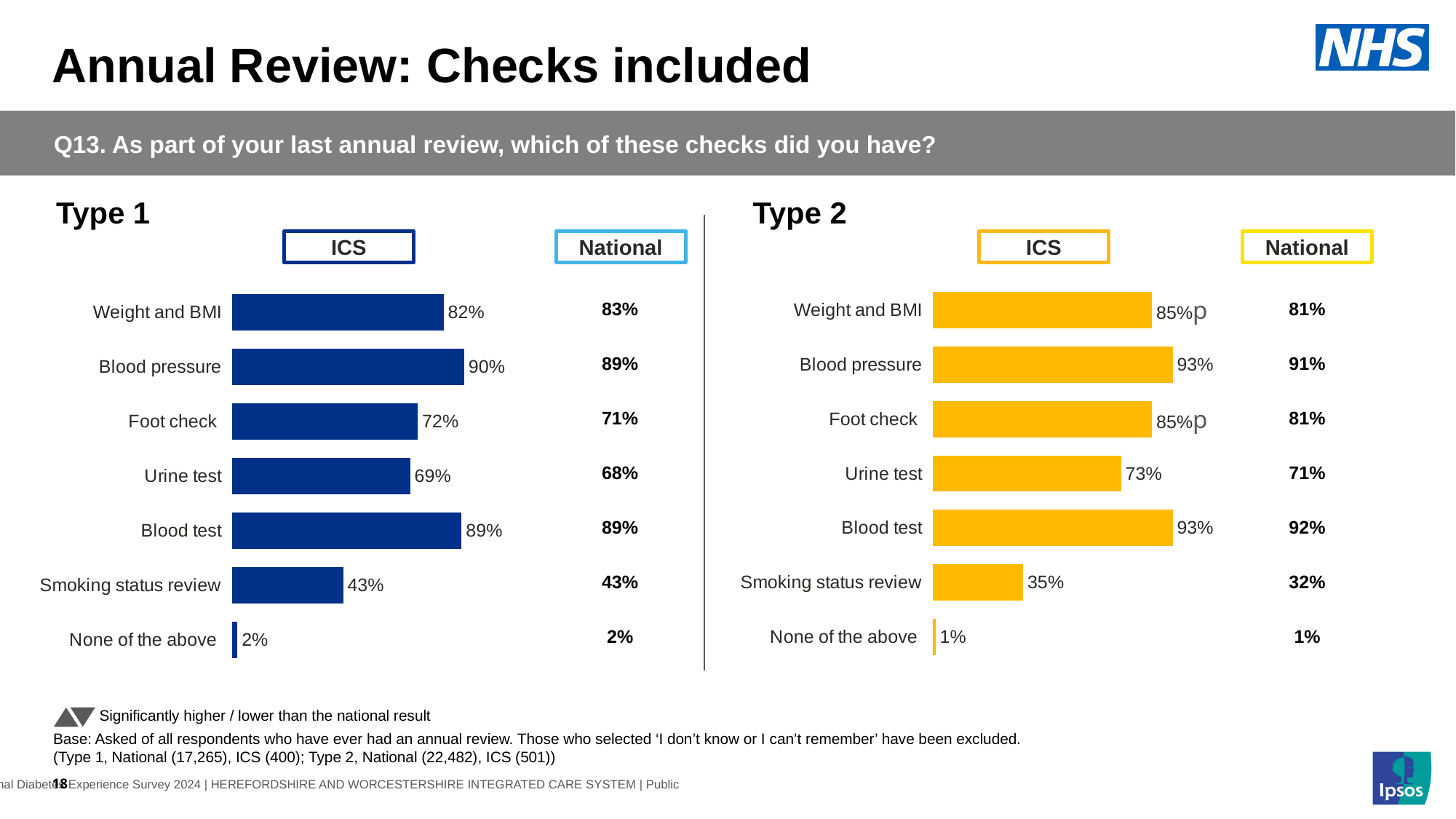
What type of chart is used for the Type 1 ICS results? Bar chart In the Type 1 chart, what is the ICS value for Blood pressure? 90% In the Type 2 chart, what is the difference between the ICS and National values for Weight and BMI? 4 percentage points In the Type 2 chart, what is the National value for Smoking status review? 32% In the Type 1 chart, which is larger: the ICS value for Foot check or the ICS value for Urine test? Foot check How many categories are shown in the Type 2 chart? 7 What colour are the bars in the Type 2 chart? Yellow In the Type 1 chart, what is the difference between the ICS values for Blood test and Smoking status review? 46 percentage points In the Type 2 chart, which category has the lowest ICS value? None of the above In the Type 1 chart, what is the National value for Foot check? 71% In the Type 1 chart, which category has the highest ICS value? Blood pressure In the Type 2 chart, what is the ICS value for Urine test? 73%